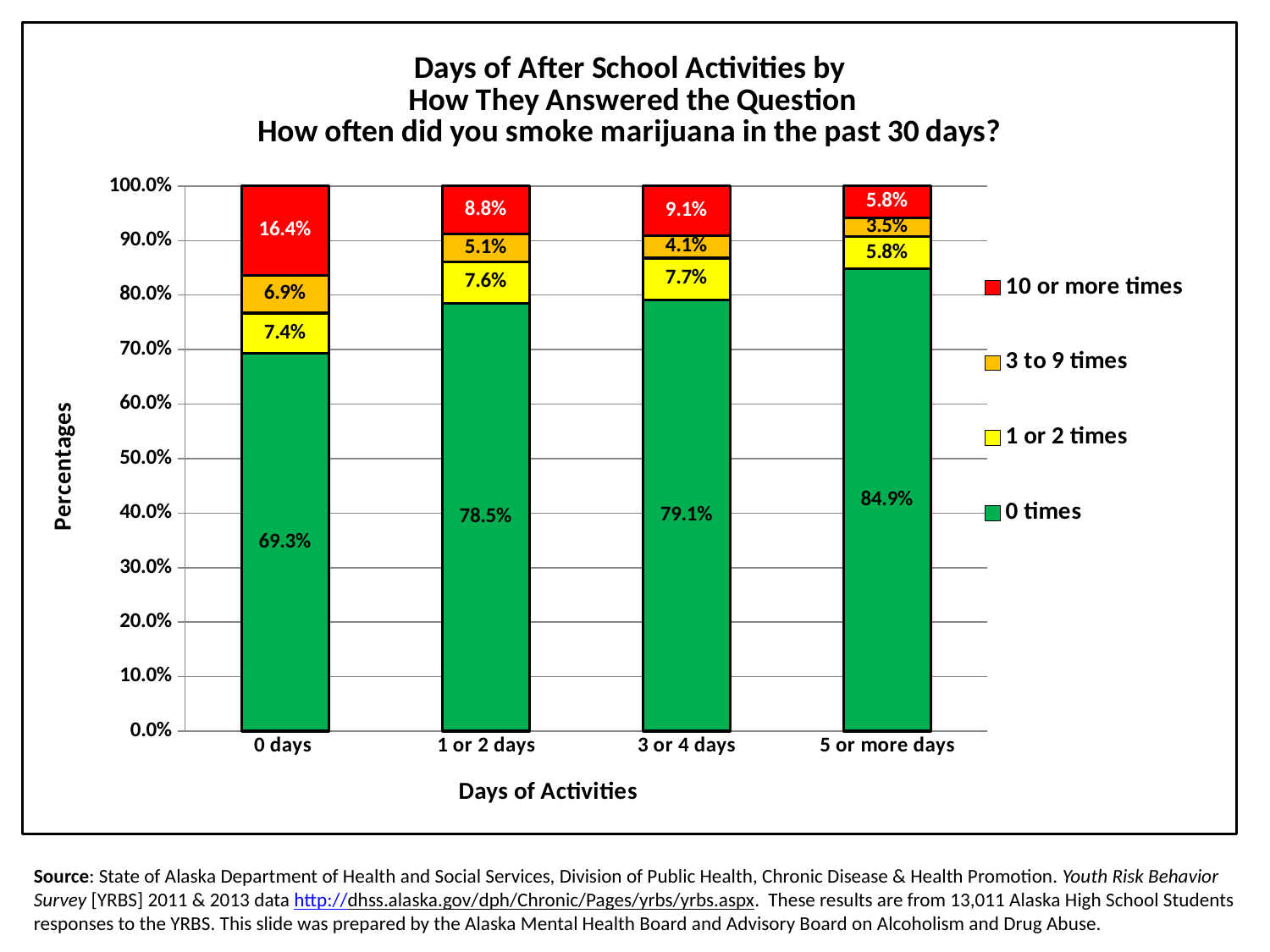
Does the 0 times percentage rise or fall as days of activities increase from 0 days to 5 or more days? Rises What percentage of students with 0 days of after school activities answered 10 or more times? 16.4% How many series does the legend list? 4 What percentage of students with 5 or more days of after school activities answered 0 times? 84.9% How many days-of-activities categories are shown on the x axis? 4 Which days-of-activities category has the lowest percentage answering 3 to 9 times? 5 or more days How much larger is the 10 or more times percentage for 0 days than for 5 or more days? 10.6 percentage points Which has a larger 0 times percentage: 1 or 2 days or 3 or 4 days? 3 or 4 days What is the value of the 3 to 9 times segment for 3 or 4 days? 4.1% What colour represents the 10 or more times series in the legend? Red What kind of chart is shown on the slide? Stacked bar chart Which days-of-activities category has the highest percentage answering 0 times? 5 or more days